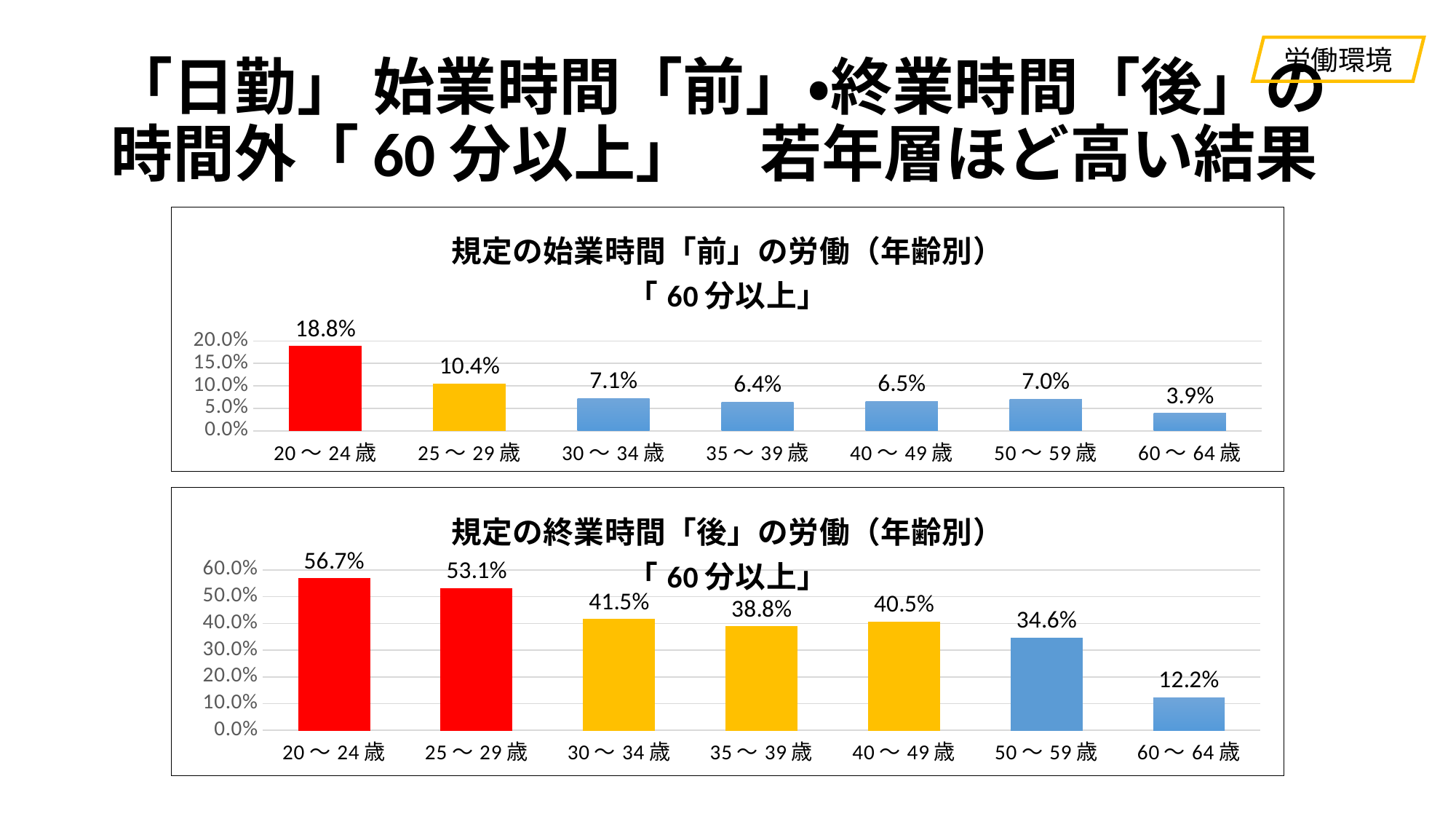
In the top chart (規定の始業時間「前」の労働), which age group has the lowest value? 60～64歳 In the bottom chart (規定の終業時間「後」の労働), which age group has the highest value? 20～24歳 In the top chart (規定の始業時間「前」の労働), how many age groups are shown? 7 In the bottom chart (規定の終業時間「後」の労働), what is the value for 35～39歳? 38.8% In the top chart (規定の始業時間「前」の労働), what is the value for 20～24歳? 18.8% In the top chart (規定の始業時間「前」の労働), what is the difference between 20～24歳 and 25～29歳? 8.4% What kind of chart is the bottom chart (規定の終業時間「後」の労働)? bar chart In the top chart (規定の始業時間「前」の労働), what is the value for 50～59歳? 7.0% In the bottom chart (規定の終業時間「後」の労働), what colour are the bars for 20～24歳 and 25～29歳? red In the bottom chart (規定の終業時間「後」の労働), is the value for 25～29歳 greater or less than 50.0%? greater In the bottom chart (規定の終業時間「後」の労働), which is larger, the value for 30～34歳 or 40～49歳? 30～34歳 In the bottom chart (規定の終業時間「後」の労働), what is the difference between 50～59歳 and 60～64歳? 22.4%